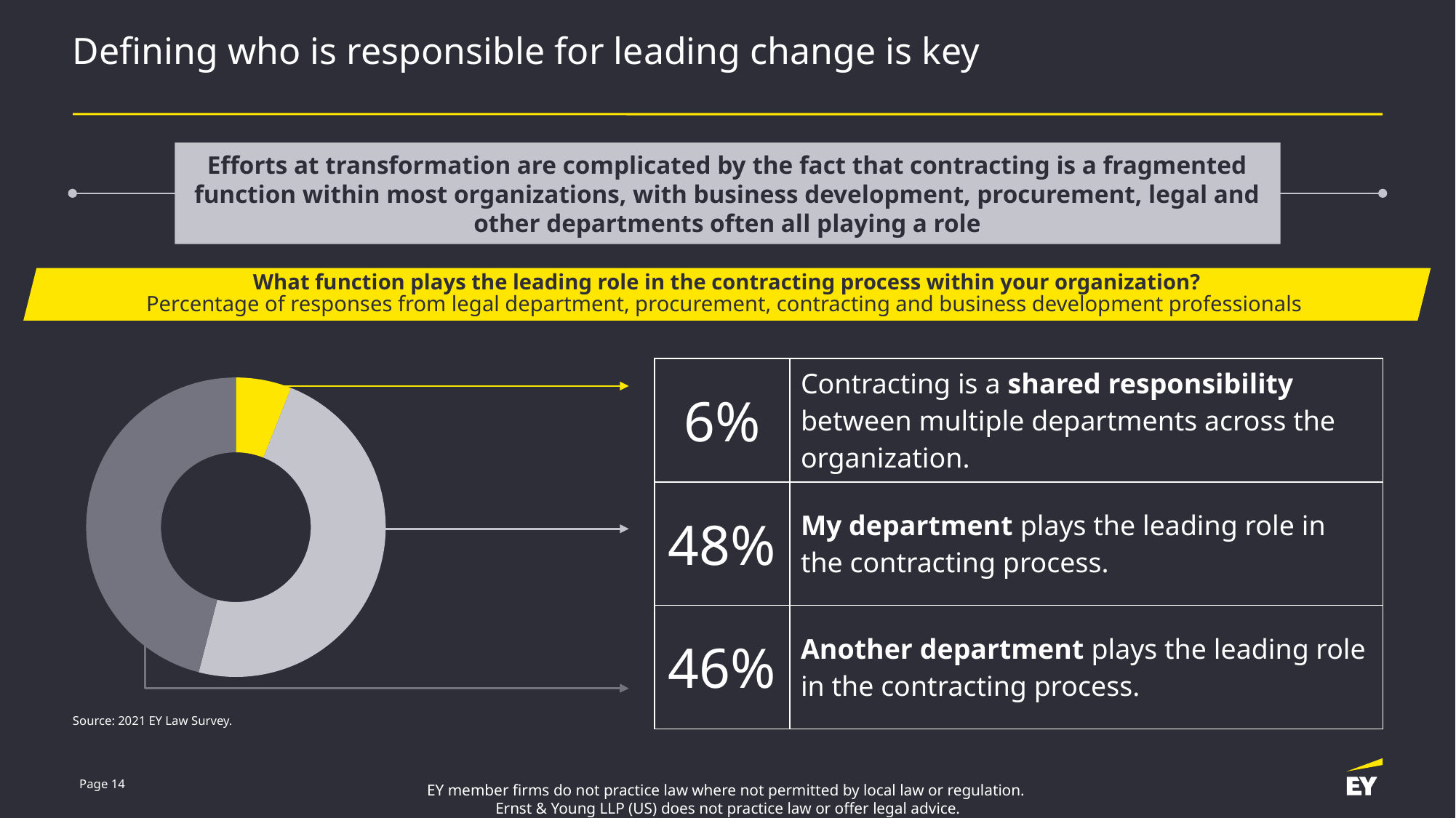
Which response has the largest share of the donut chart? My department plays the leading role in the contracting process Which slice of the donut chart is coloured yellow? The 6% slice (shared responsibility) What kind of chart is shown on the slide? Donut (pie) chart What percentage of respondents said their own department plays the leading role in the contracting process? 48% What percentage of respondents said another department plays the leading role in the contracting process? 46% What is the source cited for the chart data? 2021 EY Law Survey What is the difference in percentage points between 'Another department' and 'shared responsibility' responses? 40 percentage points Which is larger: the share for 'Another department' or the share for 'shared responsibility'? Another department How many slices does the donut chart have? 3 What percentage of respondents said contracting is a shared responsibility between multiple departments? 6% Which response has the smallest share of the donut chart? Contracting is a shared responsibility between multiple departments What is the difference in percentage points between 'My department' and 'Another department' responses? 2 percentage points